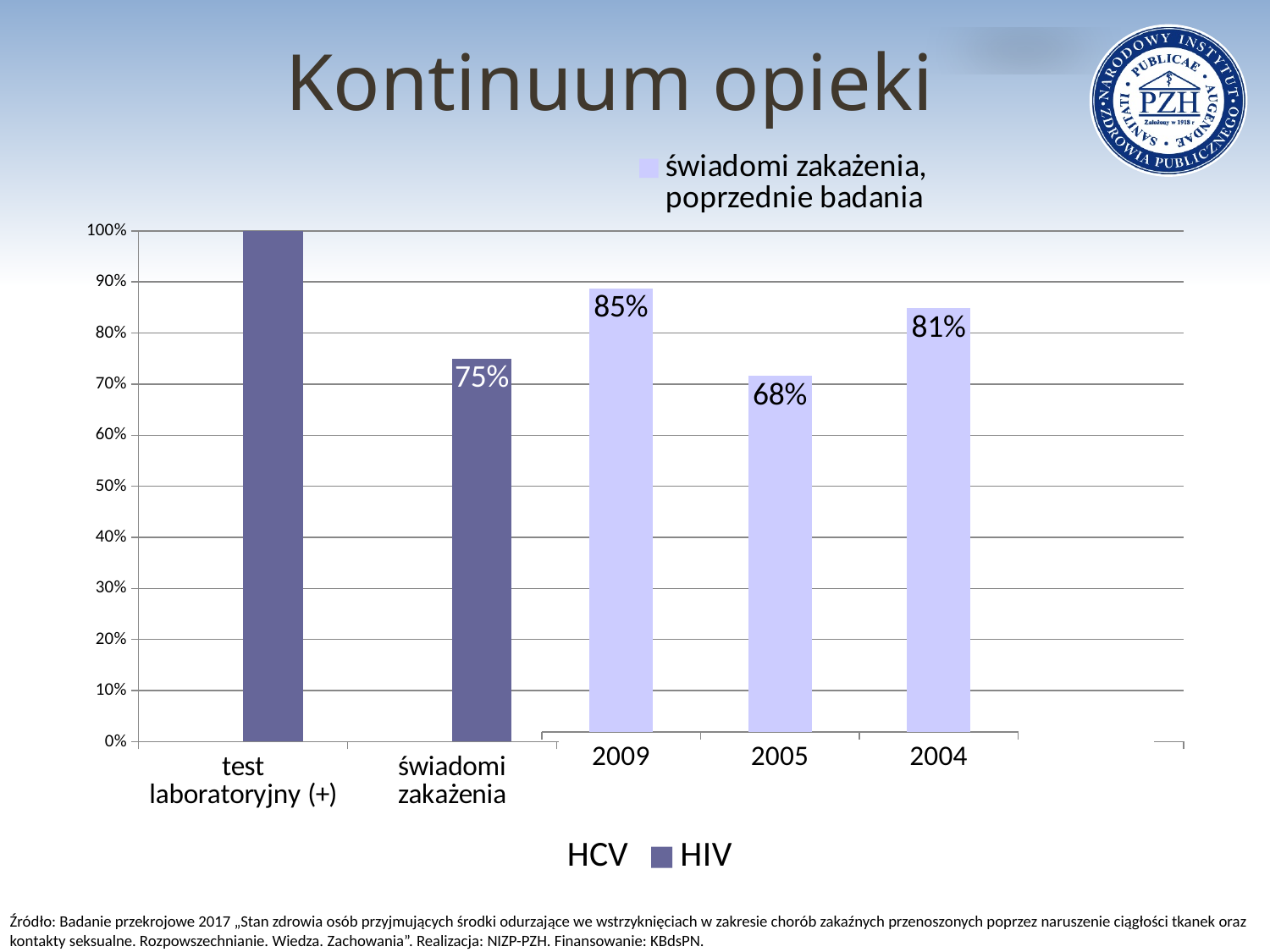
In the chart on the right titled 'świadomi zakażenia, poprzednie badania', what is the value for 2009? 85% In the chart on the right titled 'świadomi zakażenia, poprzednie badania', what is the value for 2005? 68% In the main chart on the left, what is the value for 'świadomi zakażenia'? 75% What kind of chart is the main chart on the left? Bar chart In the chart on the right titled 'świadomi zakażenia, poprzednie badania', which year has the highest value? 2009 In the chart on the right titled 'świadomi zakażenia, poprzednie badania', what is the difference between the values for 2009 and 2005? 17% Which is larger: the value for 2004 in the right chart or the value for 'świadomi zakażenia' in the left chart? 2004 How many years are shown in the chart on the right titled 'świadomi zakażenia, poprzednie badania'? 3 In the chart on the right titled 'świadomi zakażenia, poprzednie badania', what is the value for 2004? 81% In the main chart on the left, what is the value for 'test laboratoryjny (+)'? 100% In the main chart on the left, what is the difference between the values for 'test laboratoryjny (+)' and 'świadomi zakażenia'? 25% In the chart on the right titled 'świadomi zakażenia, poprzednie badania', which year has the lowest value? 2005